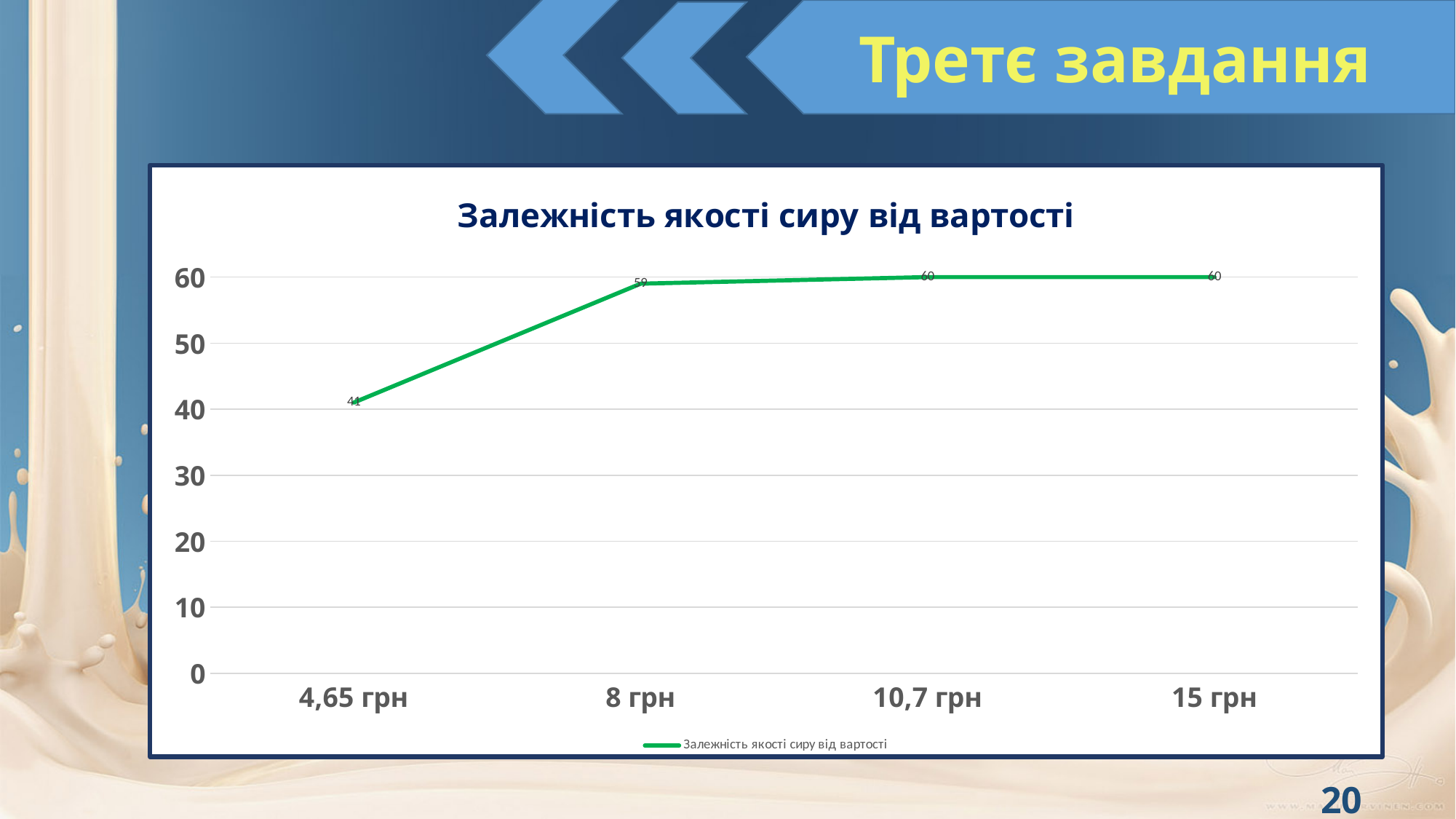
What type of chart is shown on the slide? line chart Do the values rise or fall from 4,65 грн to 15 грн? rise What is the value for 4,65 грн? 41 What is the value for 8 грн? 59 What is the value for 10,7 грн? 60 How many series does the legend list? 1 How many price categories are plotted on the x axis? 4 What is the value for 15 грн? 60 What is the difference between the values for 8 грн and 4,65 грн? 18 Which price category has the lowest value? 4,65 грн Which has a larger value, 4,65 грн or 8 грн? 8 грн What is the title of the chart? Залежність якості сиру від вартості